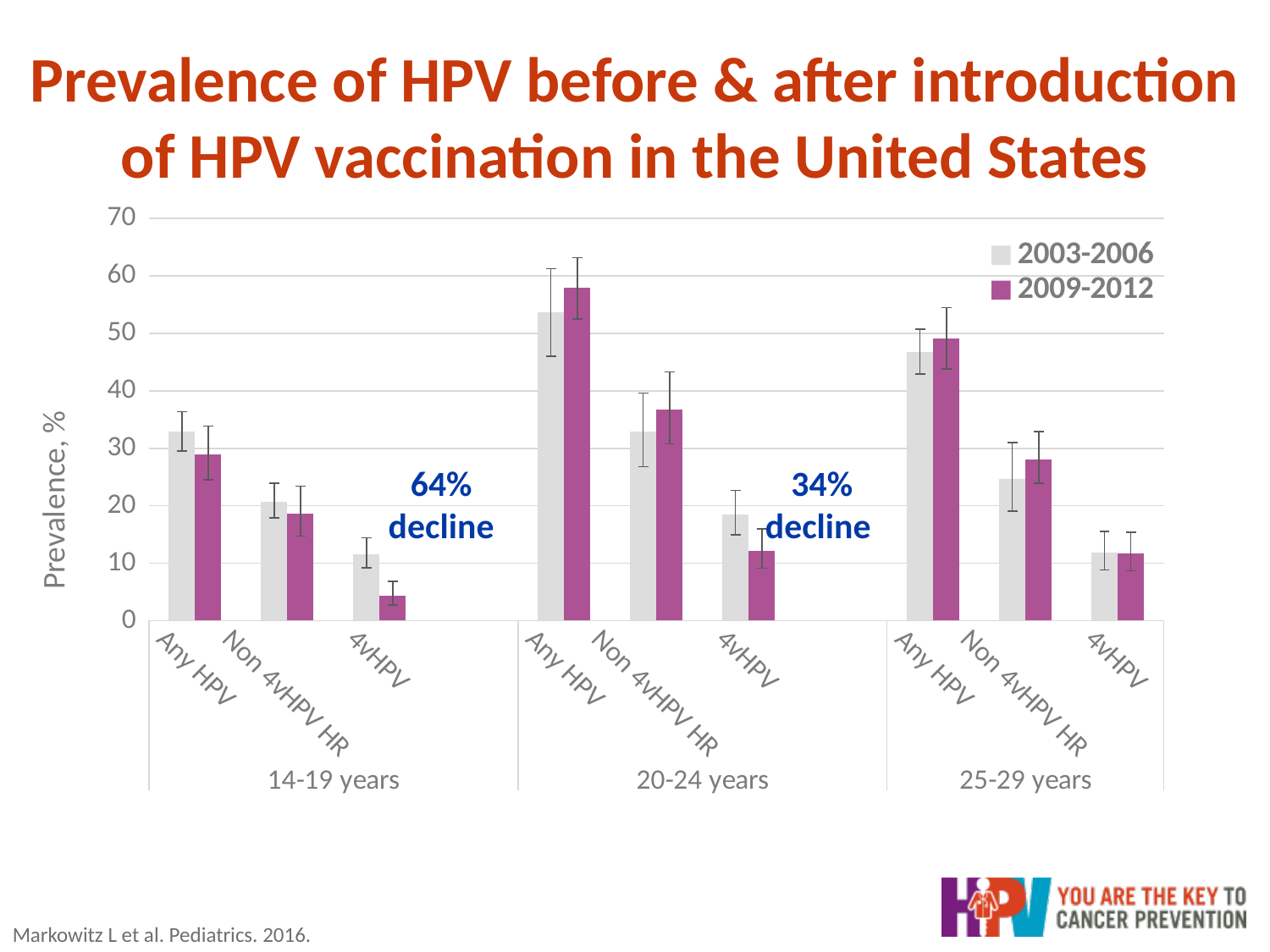
Is the 2003-2006 value for Any HPV in the 14-19 years group greater or less than 30? greater For 4vHPV in the 14-19 years group, which period has the larger value, 2003-2006 or 2009-2012? 2003-2006 Is the 2009-2012 value for 4vHPV in the 14-19 years group greater or less than 10? less How many age groups are shown along the x axis? 3 What is the label on the y axis? Prevalence, % Is the 2009-2012 value for Any HPV in the 20-24 years group greater or less than 50? greater How many series does the legend list? 2 Within the 14-19 years group, which HPV category has the lowest 2009-2012 prevalence? 4vHPV Which age group has the highest Any HPV prevalence? 20-24 years What type of chart is shown on the slide? bar chart For 4vHPV in the 20-24 years group, which period has the larger value, 2003-2006 or 2009-2012? 2003-2006 What are the two time periods listed in the legend? 2003-2006 and 2009-2012